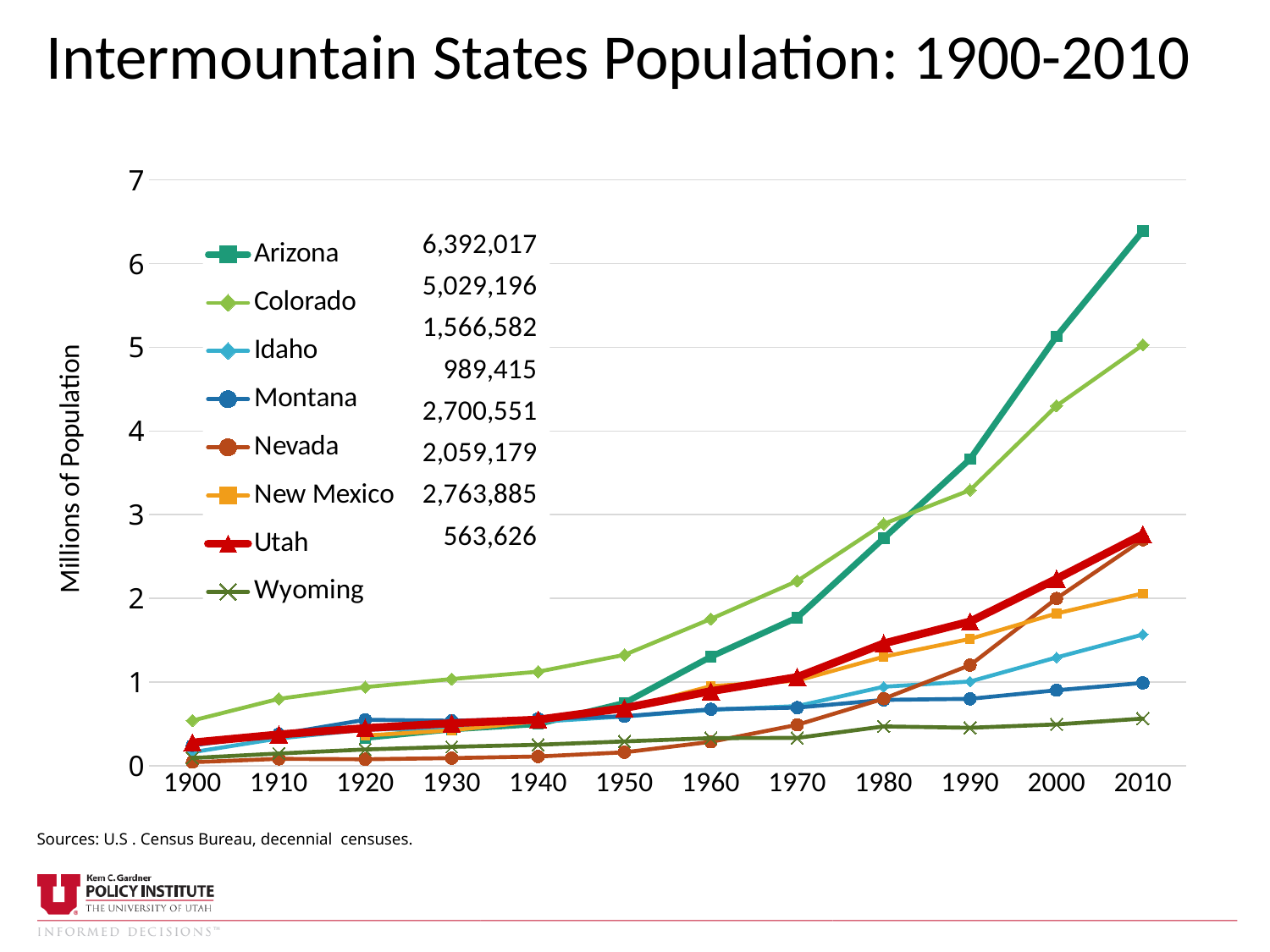
What is the label on the y axis? Millions of Population How many states (series) does the legend list? 8 How many census years are plotted along the x axis? 12 What kind of chart is shown on the slide? line chart Which state has the highest population in 1900? Colorado Which state has the highest population in 2010? Arizona Is the value for Utah in 2010 greater or less than 3 million? less What 2010 population figure is printed beside the Arizona legend entry? 6,392,017 In 1970, which has the larger population, Colorado or Arizona? Colorado Is the value for Arizona in 2010 greater or less than 6 million? greater Does Arizona's population rise or fall from 1900 to 2010? rise Which state has the lowest population in 2010? Wyoming